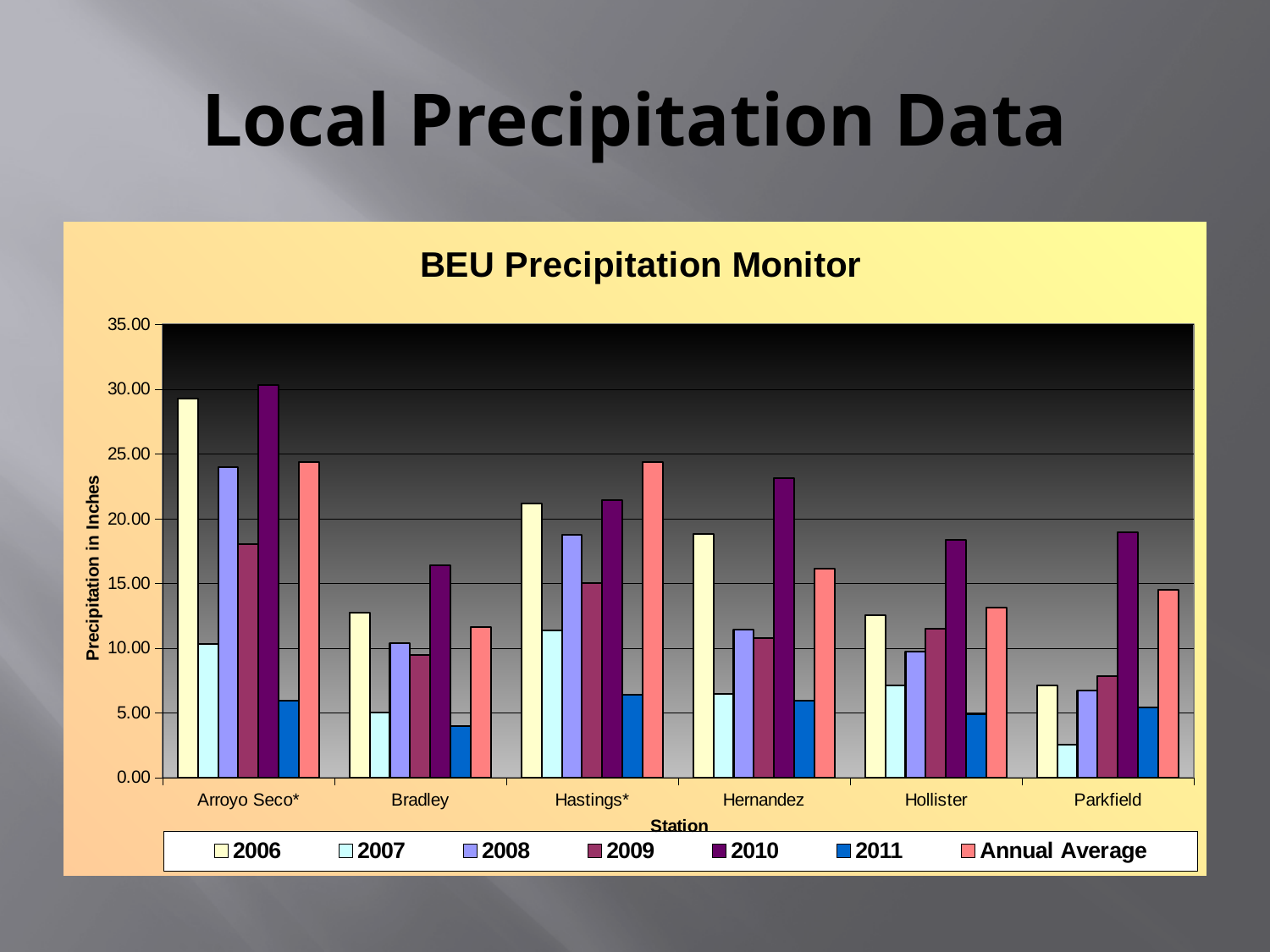
Which station has the lowest 2007 value? Parkfield Which station has the larger Annual Average value, Bradley or Hollister? Hollister Is the 2007 value for Parkfield greater or less than 5.00? less Is the 2006 value for Arroyo Seco* greater or less than 25.00? greater How many stations are shown on the x axis? 6 Is the Annual Average value for Hastings* greater or less than 20.00? greater Which station has the highest 2010 value? Arroyo Seco* What is the title of the chart? BEU Precipitation Monitor How many series does the legend list? 7 For Hernandez, which is larger: the 2006 value or the 2010 value? 2010 What kind of chart is shown on the slide? Bar chart For Parkfield, which series has the highest bar? 2010